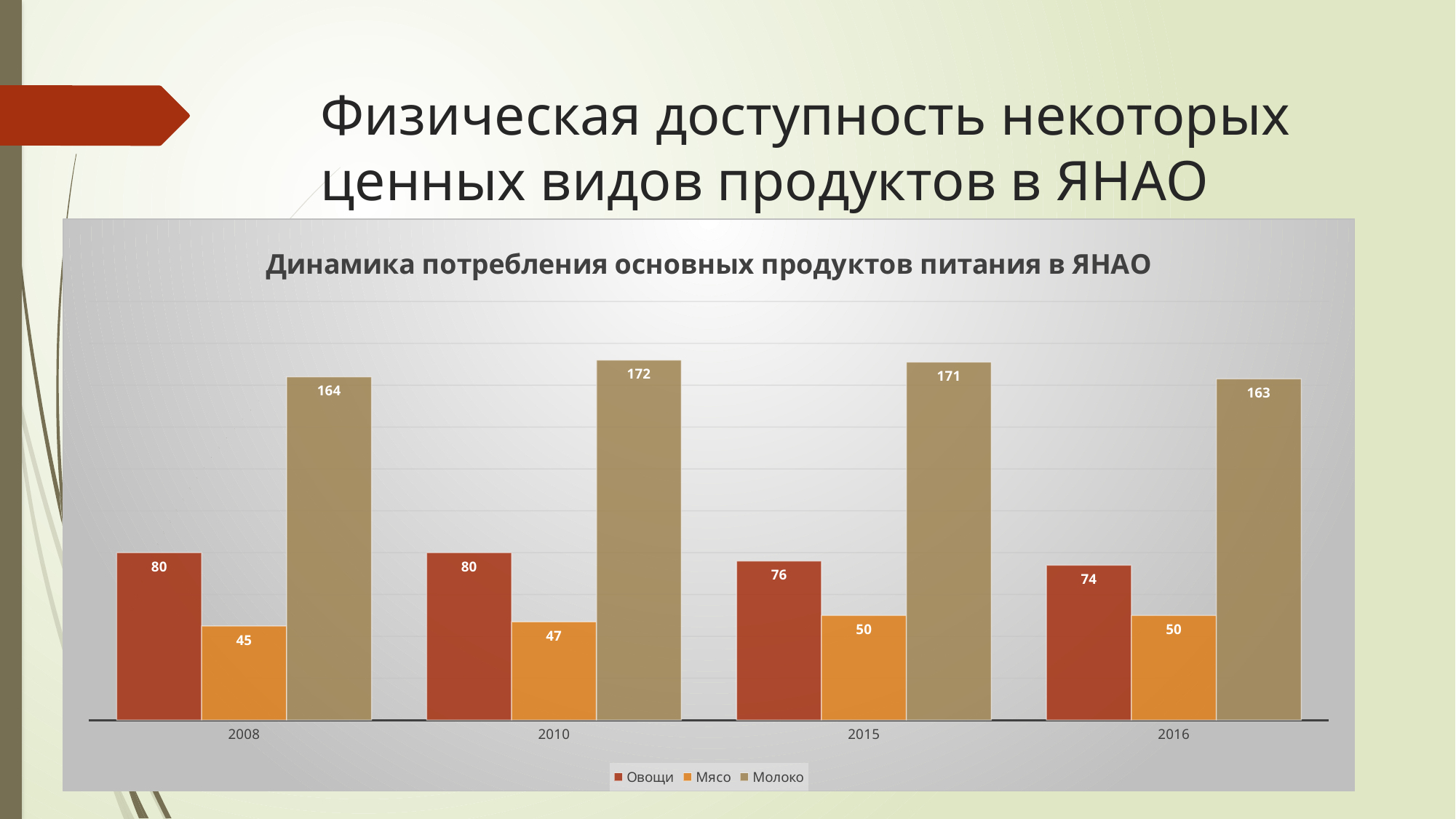
What is the value for Овощи in 2016? 74 What is the difference between the Овощи values for 2008 and 2015? 4 Which is larger: Овощи in 2015 or Овощи in 2016? Овощи in 2015 How many series does the legend list? 3 What is the value for Мясо in 2008? 45 What kind of chart is shown on the slide? Bar chart What is the title of the chart? Динамика потребления основных продуктов питания в ЯНАО What is the value for Молоко in 2010? 172 In which year is the Мясо value lowest? 2008 What is the difference between the Молоко values for 2010 and 2016? 9 In which year is the Молоко value highest? 2010 How many years are shown on the x axis? 4